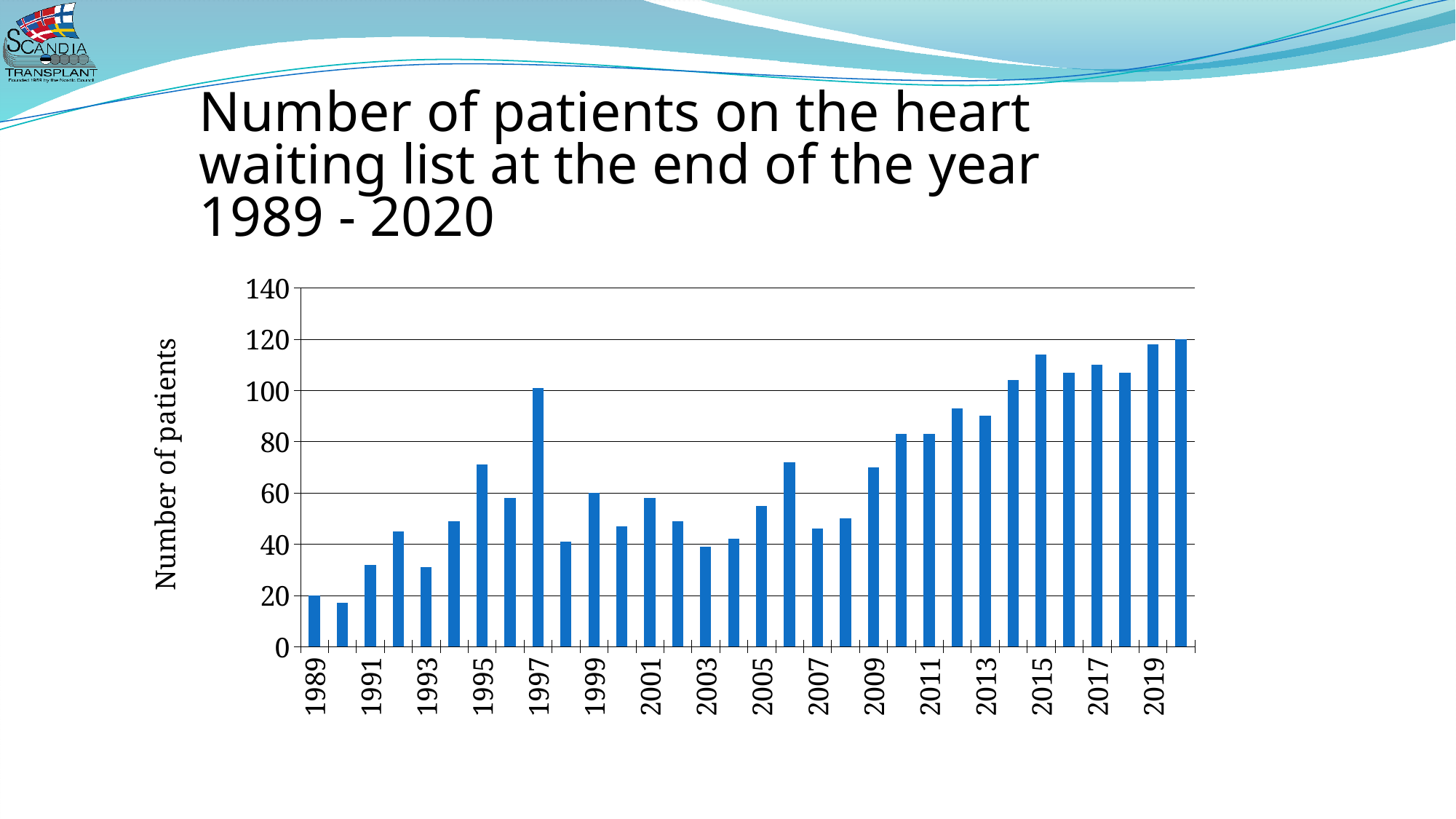
Is the value for 1997 greater or less than 80? greater What kind of chart is shown on the slide? bar chart Which year has the lowest number of patients on the heart waiting list? 1990 Do the values generally rise or fall from 2009 to 2020? rise Which year has the larger value, 2013 or 2014? 2014 What is the label on the vertical axis of the chart? Number of patients Is the value for 2015 greater or less than 100? greater How many years (bars) are plotted in the chart? 32 Which year has the larger value, 1995 or 1997? 1997 Is the value for 2003 greater or less than 60? less